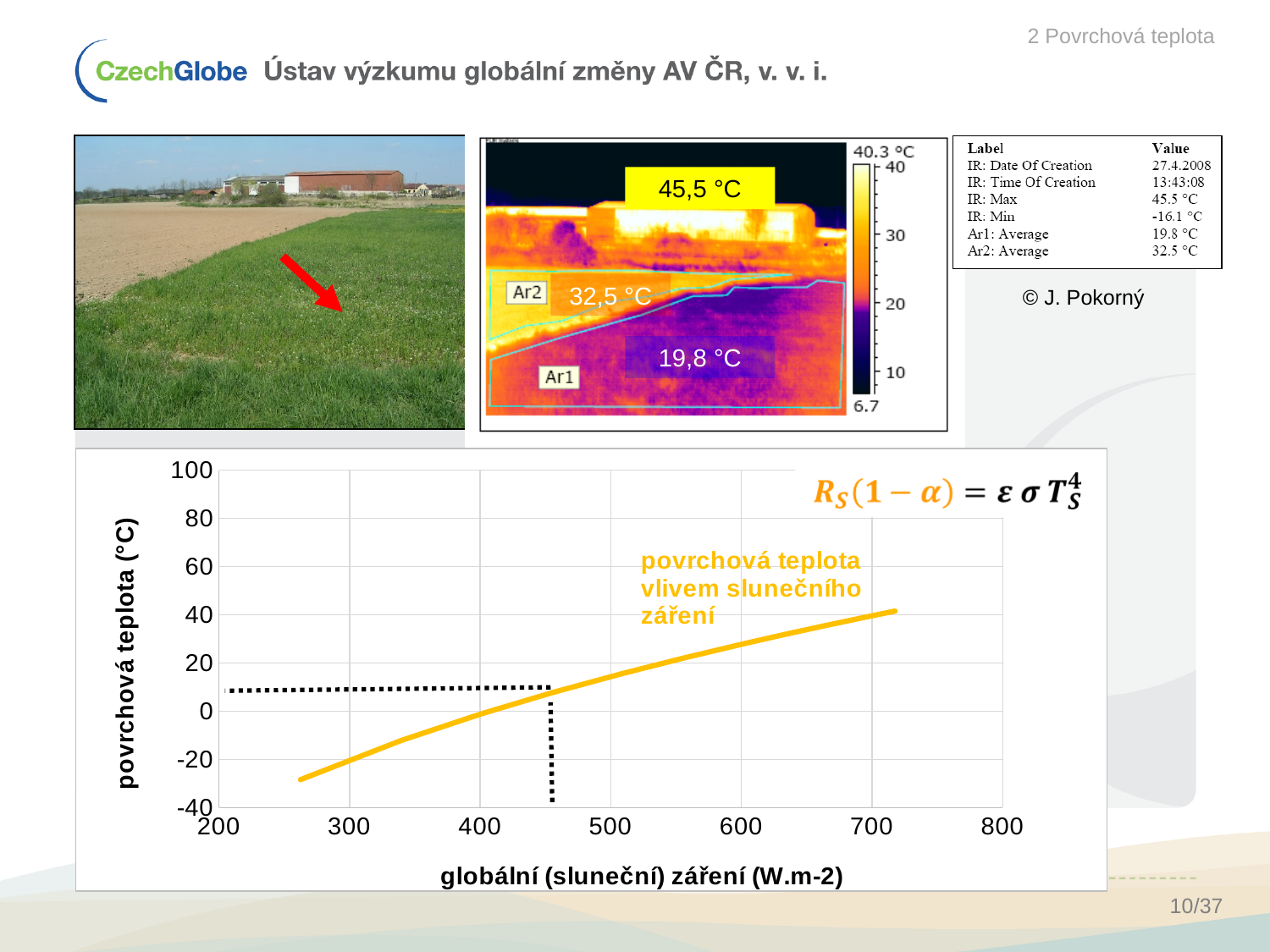
Does the surface temperature curve rise or fall as global radiation increases along the x axis? rises What is the label of the y axis of the chart? povrchová teplota (°C) What kind of chart is shown at the bottom of the slide? line chart Is the surface temperature at 500 W.m-2 greater or less than 40 °C? less What is the highest value shown on the y axis of the chart? 100 Is the surface temperature at 300 W.m-2 greater or less than 0 °C? less Is the surface temperature at 400 W.m-2 greater or less than -20 °C? greater What is the label of the x axis of the chart? globální (sluneční) záření (W.m-2) How many curves are plotted in the chart? 1 Which is higher on the curve: the surface temperature at 300 W.m-2 or at 600 W.m-2? 600 W.m-2